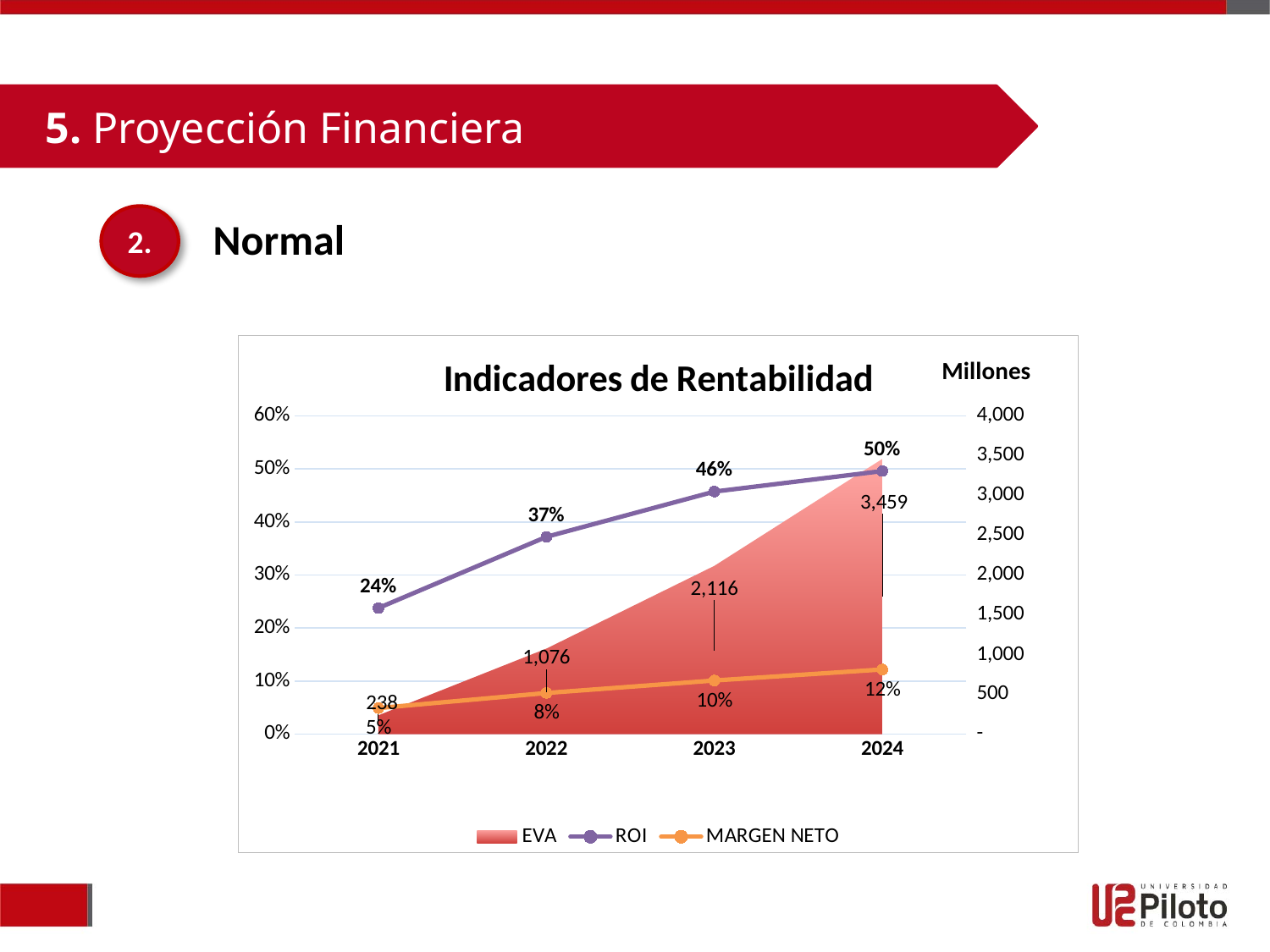
What is the EVA value for 2024? 3,459 What is the ROI value for 2023? 46% What is the difference between the ROI values for 2022 and 2021? 13% In which year is ROI highest? 2024 How many series does the legend list? 3 In which year is EVA lowest? 2021 How many years are shown on the x axis? 4 Which is larger, the MARGEN NETO value for 2024 or for 2021? 2024 What is the EVA value for 2021? 238 What is the MARGEN NETO value for 2022? 8% Does the ROI series rise or fall from 2021 to 2024? rise What is the difference between the EVA values for 2023 and 2022? 1,040